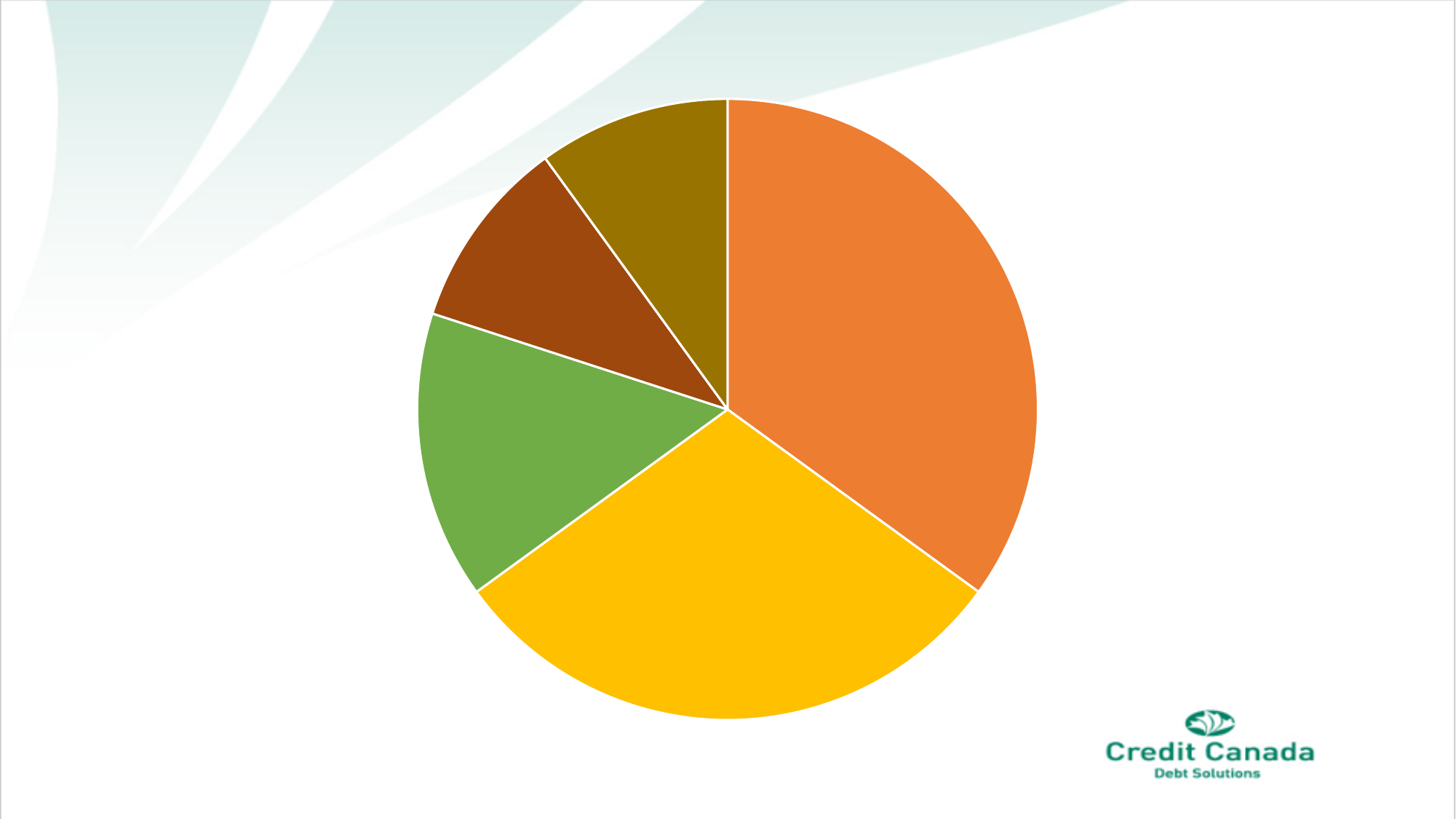
Which slice of the pie chart is the largest? the orange slice Does the pie chart show data labels on its slices? No What kind of chart is shown on the slide? pie chart How many slices does the pie chart have? 5 Which is larger in the pie chart, the yellow slice or the green slice? the yellow slice Which is larger in the pie chart, the orange slice or the green slice? the orange slice Which is larger in the pie chart, the yellow slice or the dark brown slice? the yellow slice Does the pie chart display a legend? No